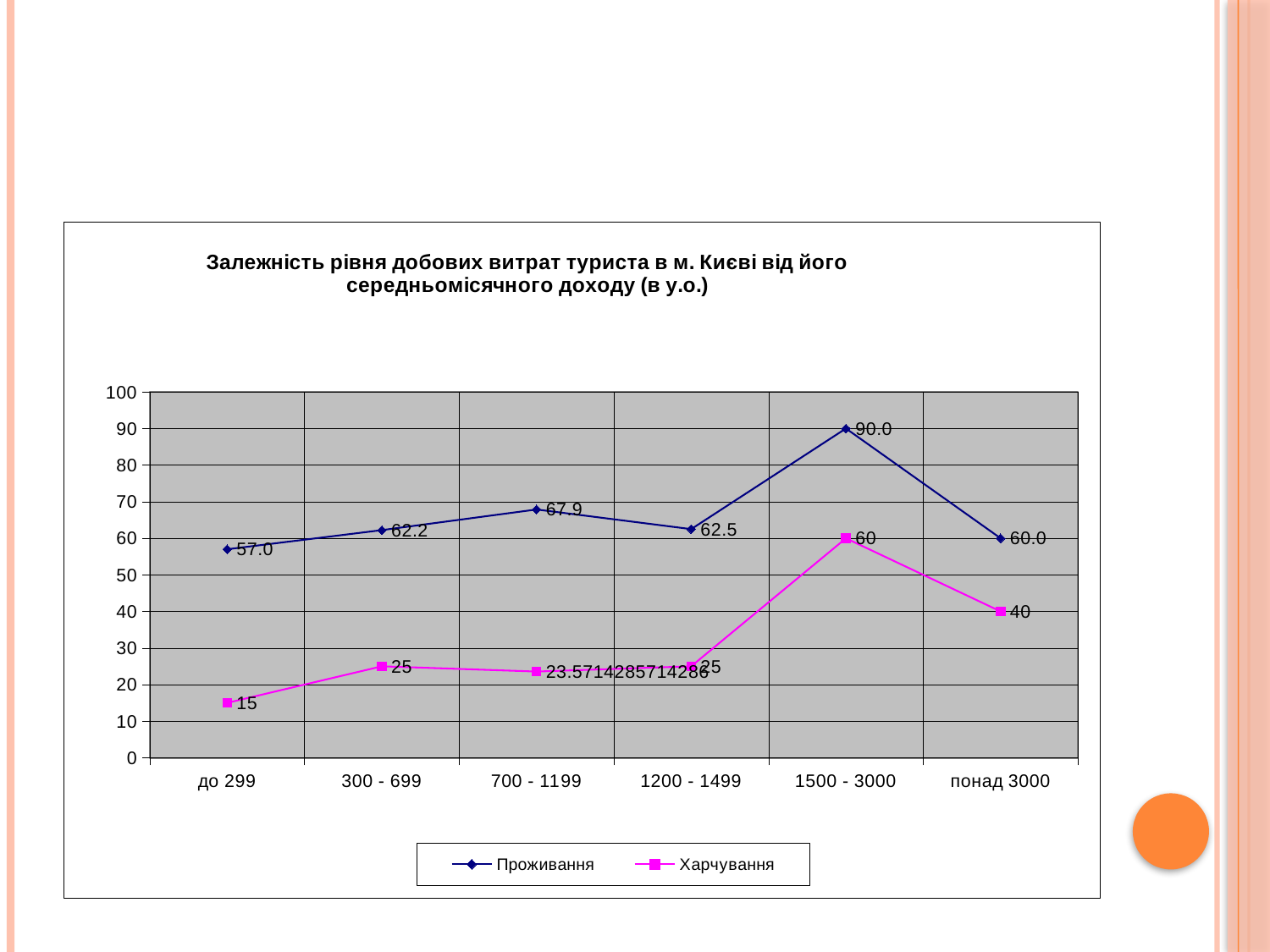
What is the value of Проживання for the income group 1500 - 3000? 90.0 What is the value of Харчування for the income group понад 3000? 40 How many series does the legend list? 2 Which is larger for the income group понад 3000: Проживання or Харчування? Проживання What type of chart is shown on the slide? line chart How many income groups are shown on the x axis? 6 What is the difference between Проживання and Харчування for the income group 1500 - 3000? 30.0 For which income group is Харчування lowest? до 299 What is the value of Харчування for the income group до 299? 15 What is the value of Проживання for the income group 700 - 1199? 67.9 Does Харчування rise or fall from 1500 - 3000 to понад 3000? fall For which income group is Проживання highest? 1500 - 3000